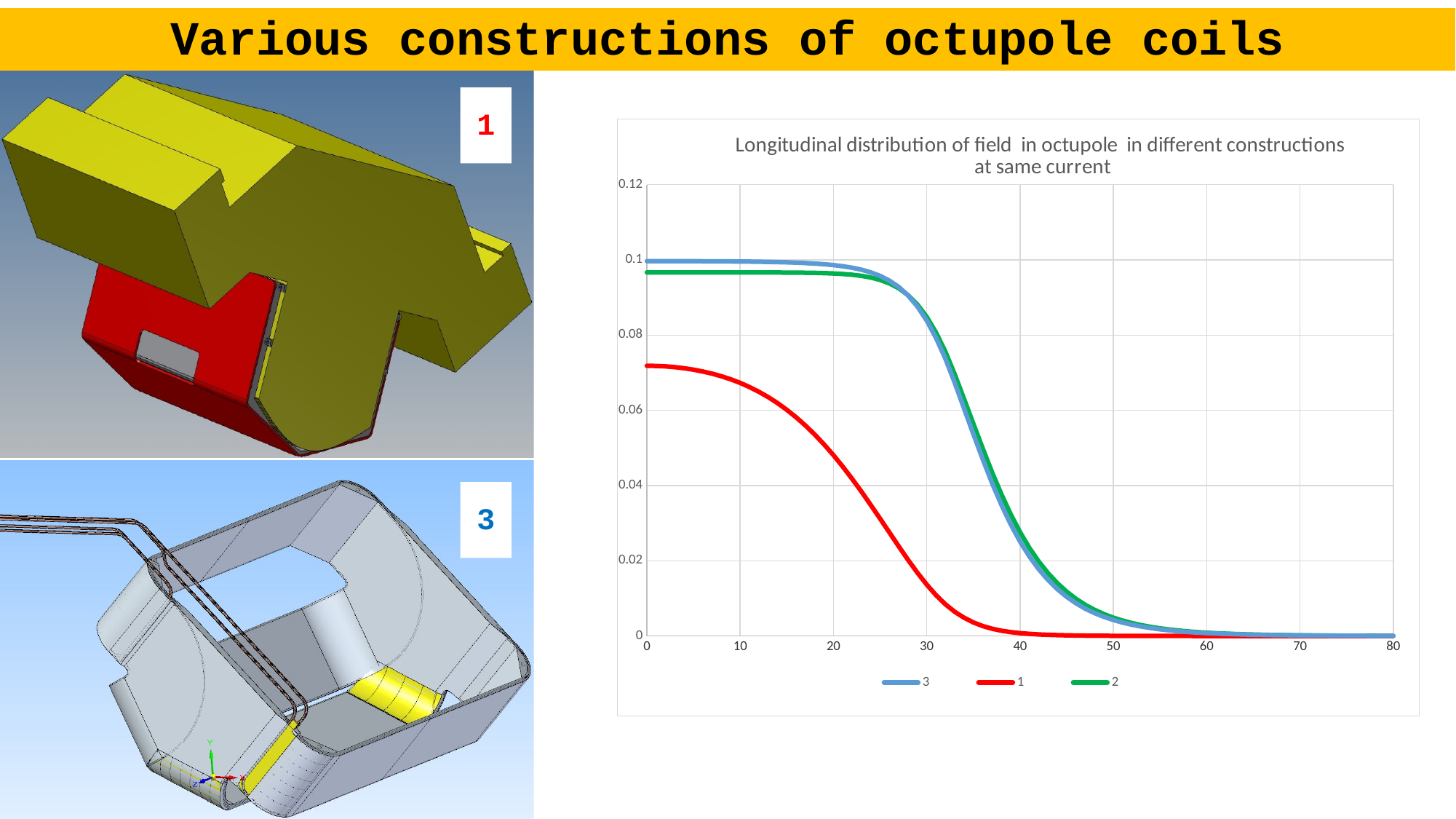
What kind of chart is shown on the slide? line chart What is the title of the chart? Longitudinal distribution of field in octupole in different constructions at same current Is the value of series 2 at x = 20 greater or less than 0.08? greater Which series has the lowest value at x = 0? 1 Is the value of series 1 at x = 0 greater or less than 0.08? less Which colour is used for series 1 in the chart? red Do the values of series 1 rise or fall as the x axis increases? fall Is the value of series 1 at x = 30 greater or less than 0.02? less At x = 20, which series has the larger value, series 3 or series 1? 3 At x = 40, which series has the larger value, series 1 or series 2? 2 How many series does the chart legend list? 3